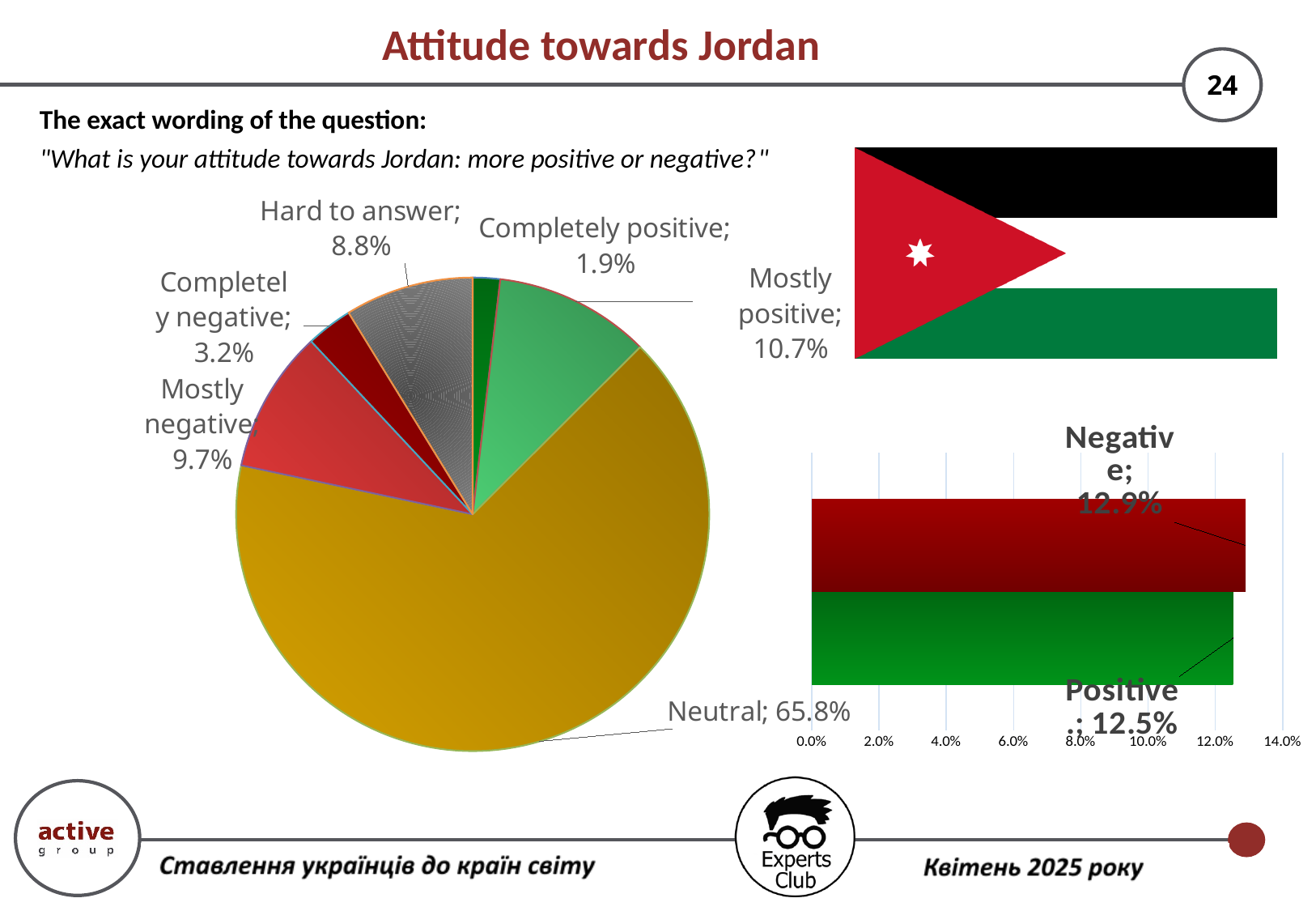
In the pie chart, what is the difference between "Mostly negative" and "Completely negative"? 6.5% In the bar chart on the right, what is the difference between "Negative" and "Positive"? 0.4% In the pie chart, which is larger: "Mostly positive" or "Mostly negative"? Mostly positive In the pie chart, which category has the largest share? Neutral In the bar chart on the right, what is the value for "Positive"? 12.5% In the bar chart on the right, what is the value for "Negative"? 12.9% What type of chart is shown on the right side of the slide? Bar chart In the pie chart, which category has the smallest share? Completely positive In the pie chart, what share of respondents answered "Neutral"? 65.8% In the pie chart, what is the value for "Hard to answer"? 8.8% How many categories does the pie chart show? 6 In the pie chart, what is the value for "Mostly positive"? 10.7%